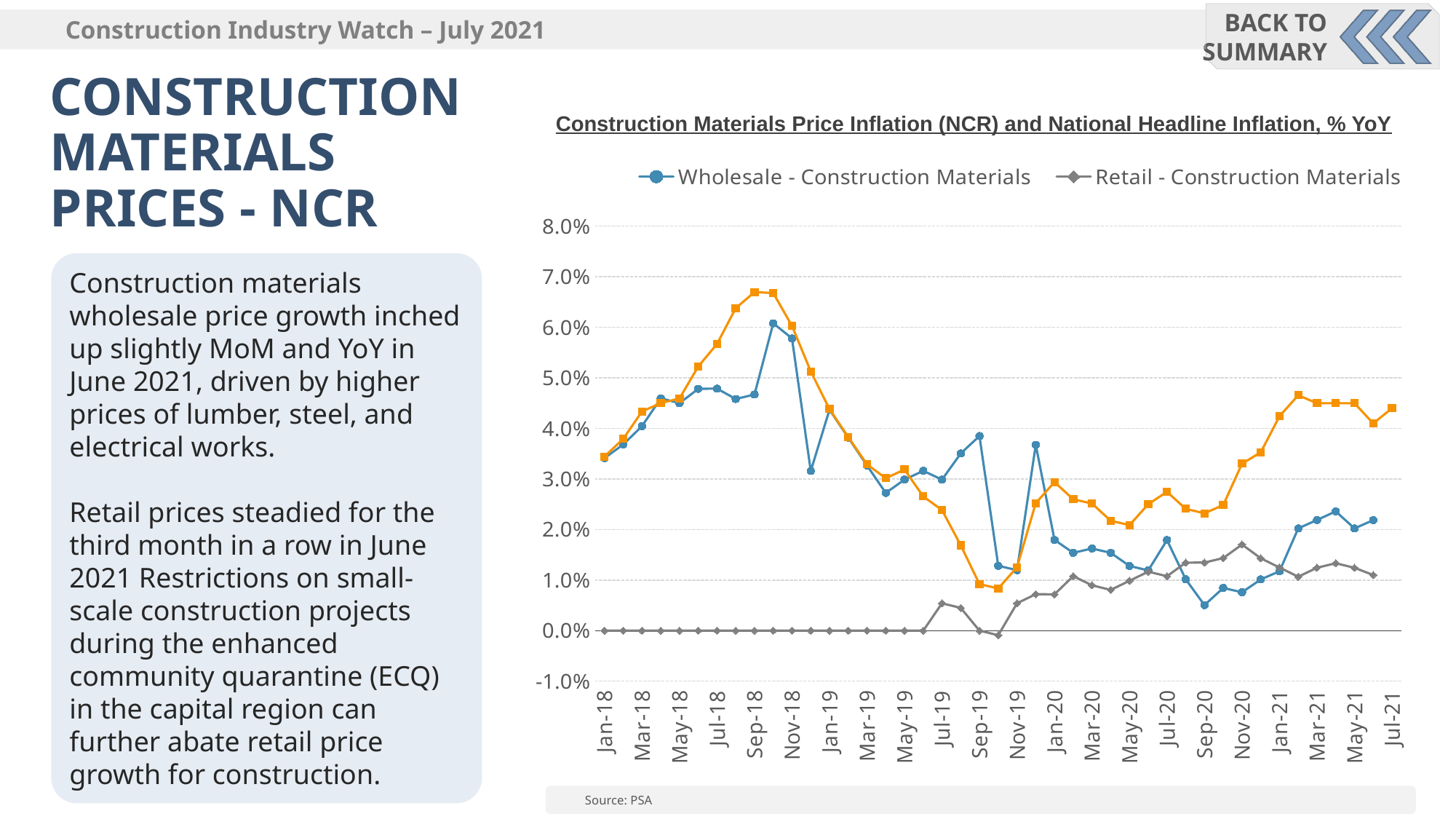
In Sep-20, which is larger: Wholesale - Construction Materials or Retail - Construction Materials? Retail - Construction Materials In which labelled month does the Retail - Construction Materials series reach its highest value? Nov-20 In Mar-21, which is larger: Wholesale - Construction Materials or Retail - Construction Materials? Wholesale - Construction Materials Does the Wholesale - Construction Materials series rise or fall from Jan-18 to Sep-18? rise How many month labels are shown on the x axis? 22 Is the Retail - Construction Materials value in Nov-20 greater or less than 2.0%? less How many series does the chart legend list? 2 Is the Wholesale - Construction Materials value in Sep-20 greater or less than 1.0%? less What is the Retail - Construction Materials value in Jan-18? 0.0% What is the title of the chart? Construction Materials Price Inflation (NCR) and National Headline Inflation, % YoY Is the Wholesale - Construction Materials value in Jan-18 greater or less than 3.0%? greater What kind of chart is shown on the slide? line chart